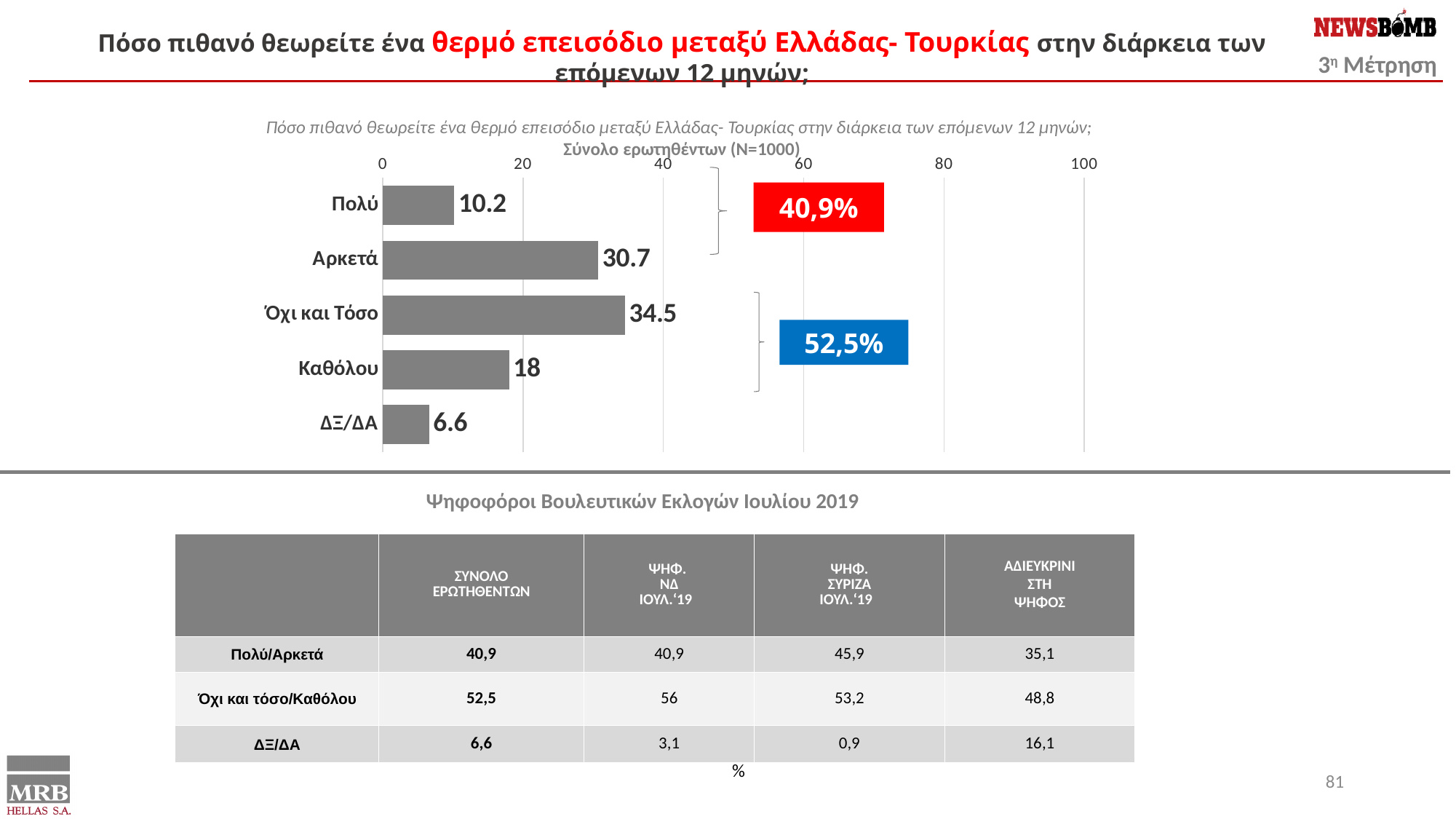
What is the value for Καθόλου? 18 Is the value for Όχι και Τόσο greater or less than 40? less What kind of chart is shown on the slide? bar chart What is the value for Όχι και Τόσο? 34.5 Which category has the lowest value? ΔΞ/ΔΑ What percentage is shown in the red callout box next to the Πολύ and Αρκετά bars? 40,9% What is the value for ΔΞ/ΔΑ? 6.6 Which is larger, the value for Καθόλου or the value for Αρκετά? Αρκετά What is the value for Πολύ? 10.2 What is the difference between the values for Αρκετά and Πολύ? 20.5 Which category has the highest value? Όχι και Τόσο How many categories are shown in the bar chart? 5